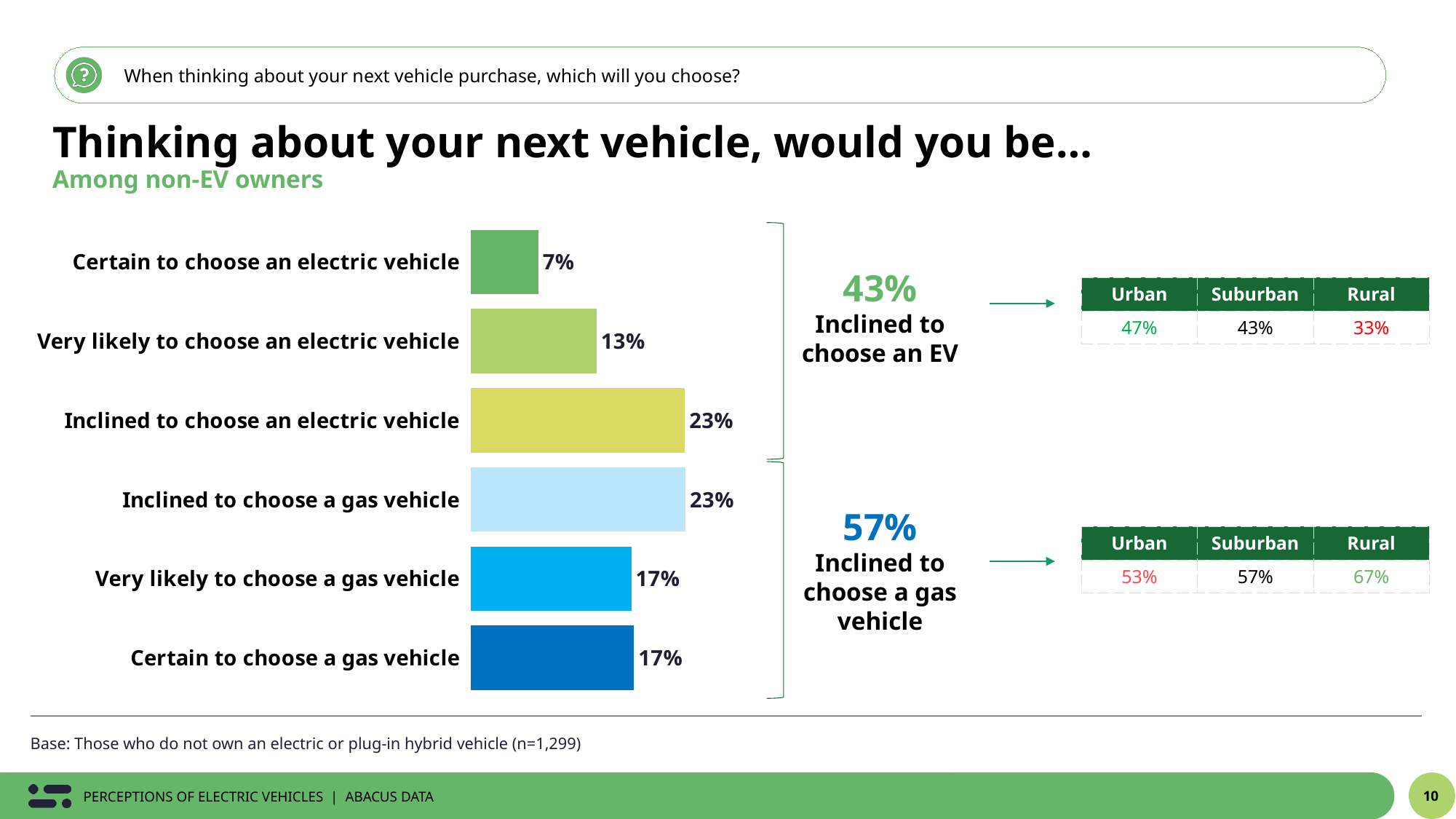
In the table for those inclined to choose a gas vehicle, what is the value for Rural? 67% Which category has the lowest value in the bar chart? Certain to choose an electric vehicle Which is larger: 'Very likely to choose a gas vehicle' or 'Very likely to choose an electric vehicle'? Very likely to choose a gas vehicle What is the value for 'Certain to choose a gas vehicle'? 17% In the table for those inclined to choose an EV, what is the value for Urban? 47% What is the value for 'Inclined to choose a gas vehicle'? 23% How many categories are shown in the bar chart? 6 What is the combined share of respondents inclined to choose an EV, as shown on the slide? 43% What is the value for 'Very likely to choose an electric vehicle'? 13% What is the difference between 'Inclined to choose an electric vehicle' and 'Certain to choose an electric vehicle'? 16% What percentage of non-EV owners are certain to choose an electric vehicle for their next vehicle? 7% What kind of chart is shown on the slide? Bar chart